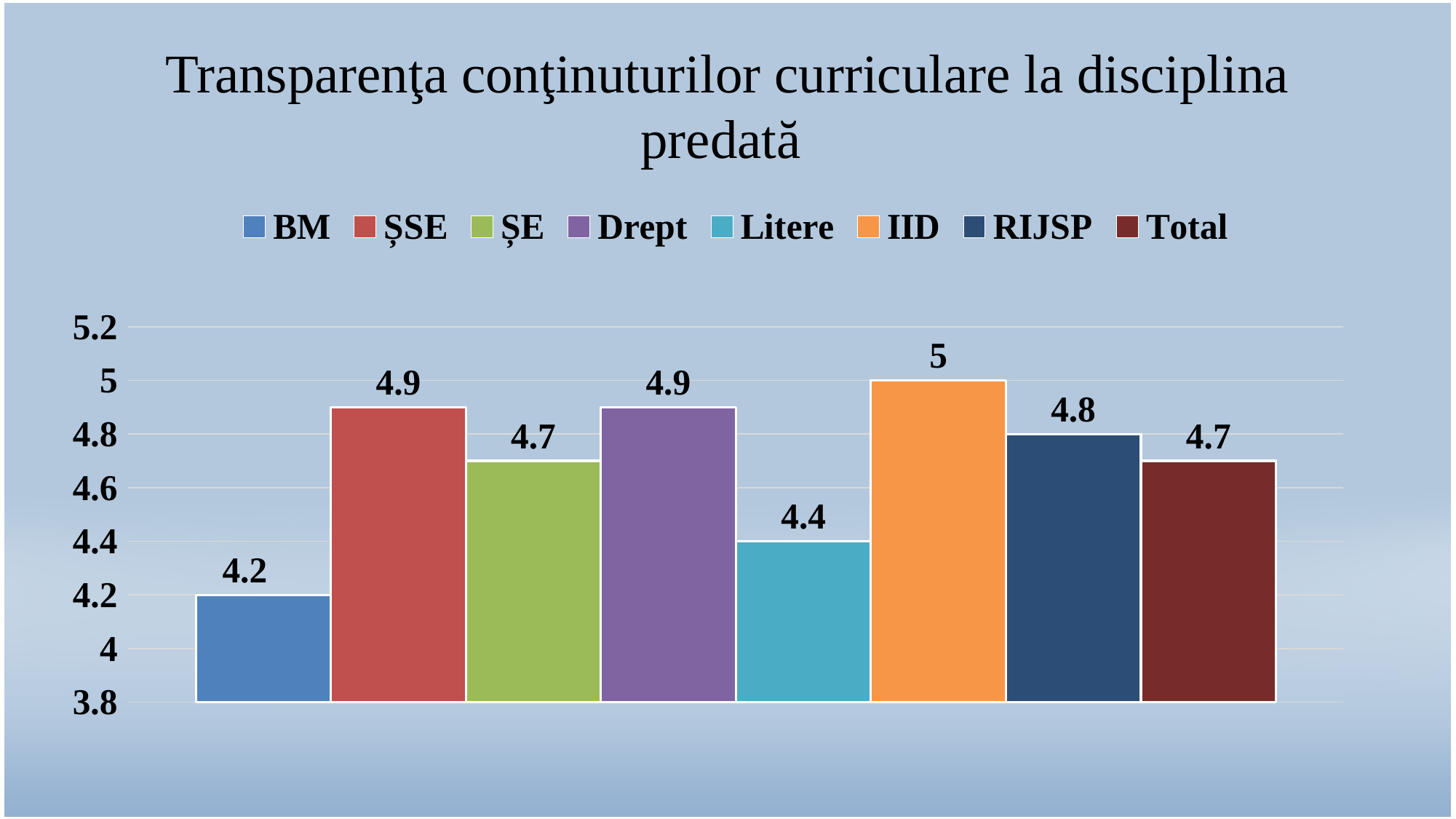
What is the value for BM? 4.2 How many bars are shown in the chart? 8 Which category has the highest value? IID What is the value for Litere? 4.4 Which is larger, the value for ȘE or the value for RIJSP? RIJSP What is the title of the chart? Transparenţa conţinuturilor curriculare la disciplina predată What is the difference between the values for IID and BM? 0.8 What kind of chart is shown on the slide? bar chart Which category has the lowest value? BM What is the value for Total? 4.7 What is the value for IID? 5 What is the difference between the values for RIJSP and Litere? 0.4